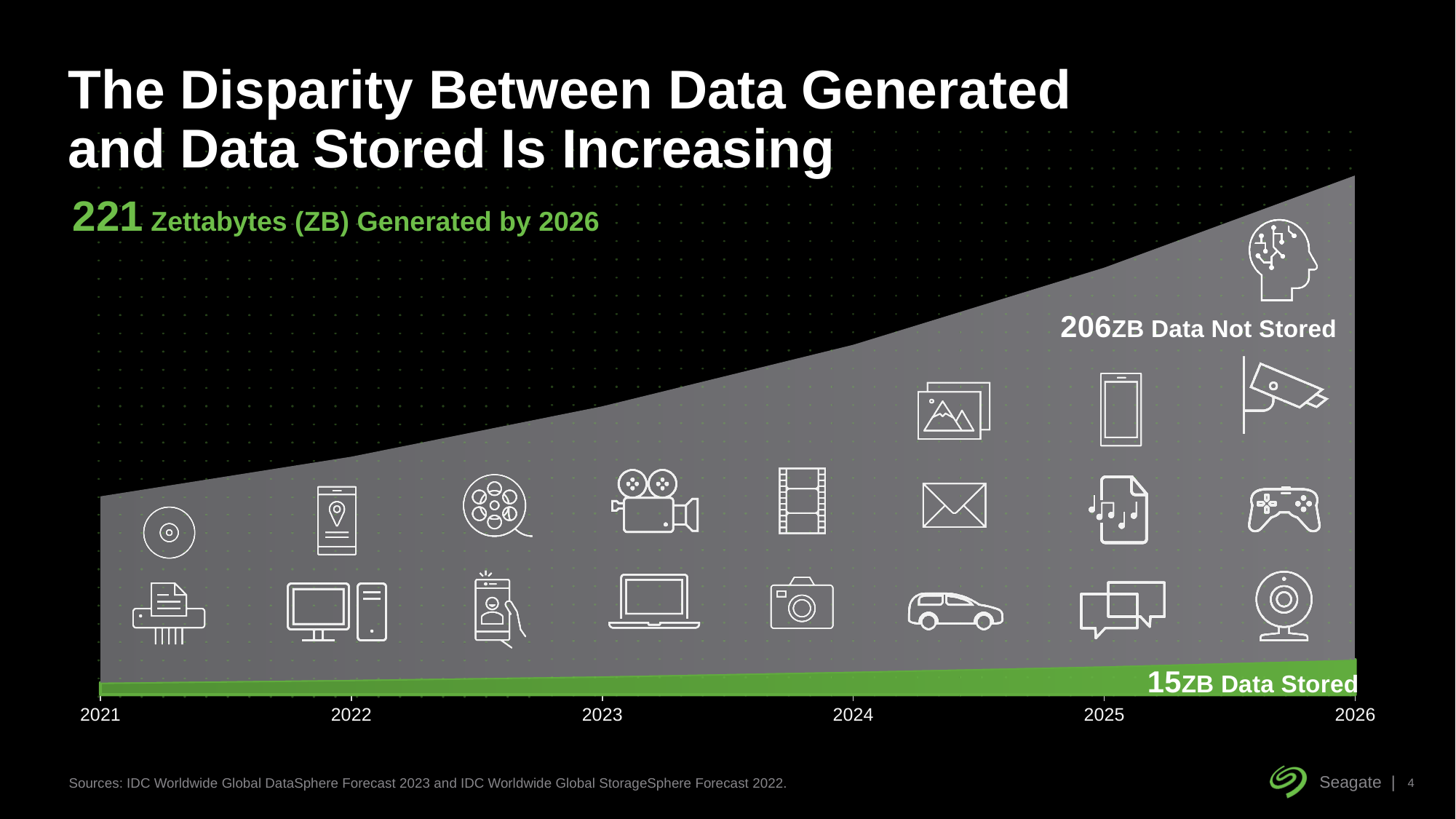
What is the value labelled for Data Not Stored in 2026? 206ZB How many years are shown on the x axis? 6 What is the value labelled for Data Stored in 2026? 15ZB What kind of chart is shown on the slide? area chart Does the total data generated rise or fall from 2021 to 2026? rise What is the first year shown on the x axis? 2021 What is the difference between Data Not Stored and Data Stored in 2026? 191ZB How many zettabytes are generated by 2026 according to the slide? 221 What colour is the Data Stored area? green What is the combined total of Data Not Stored and Data Stored in 2026? 221ZB Which is larger in 2026, Data Not Stored or Data Stored? Data Not Stored What is the last year shown on the x axis? 2026